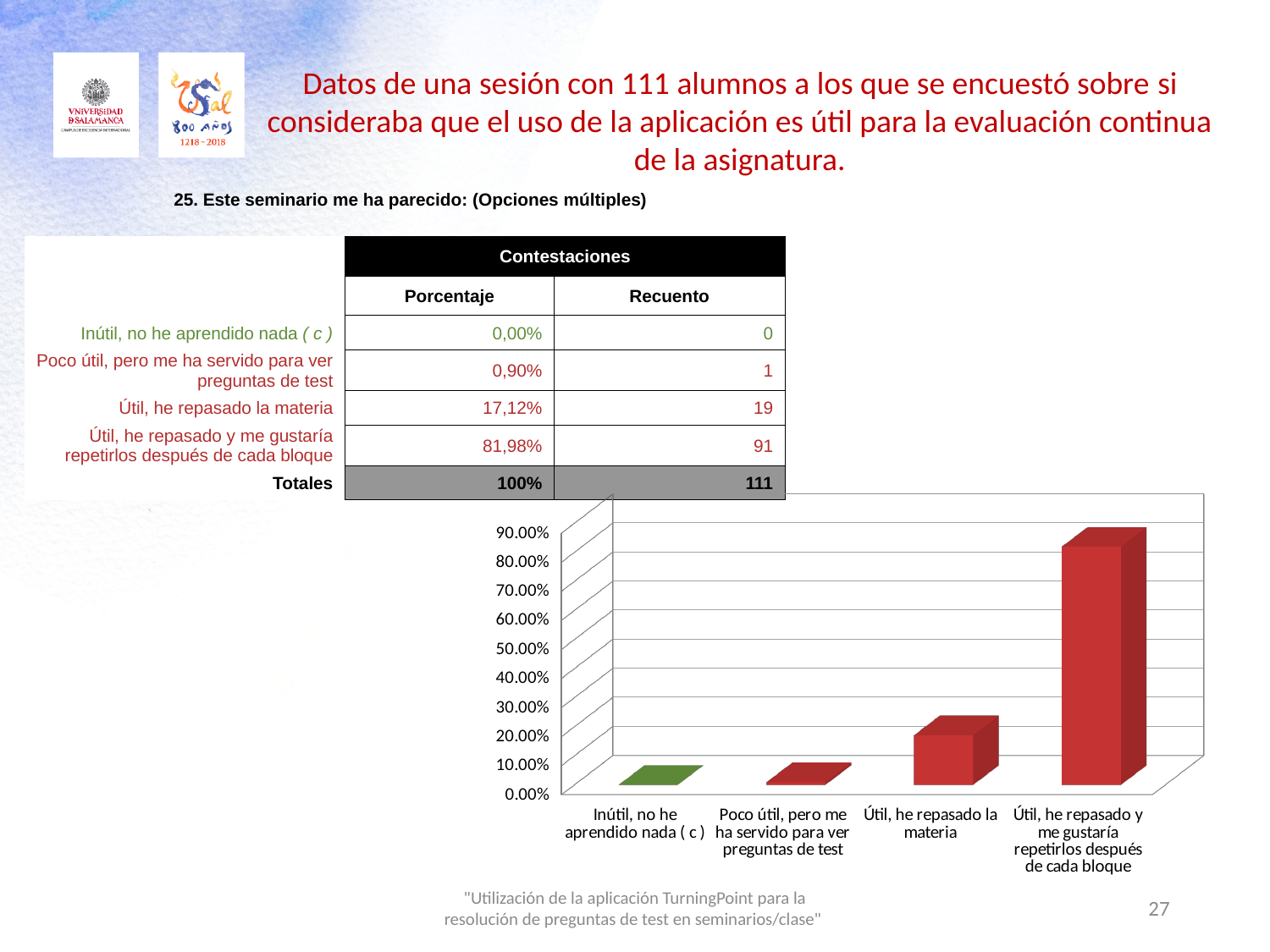
Using the Recuento values in the table, what is the difference between 'Útil, he repasado y me gustaría repetirlos después de cada bloque' and 'Útil, he repasado la materia'? 72 Which category has the lowest value in the chart? Inútil, no he aprendido nada ( c ) What kind of chart is shown on the slide? bar chart Which has a larger value in the chart: 'Poco útil, pero me ha servido para ver preguntas de test' or 'Útil, he repasado la materia'? Útil, he repasado la materia What is the highest tick label shown on the chart's vertical axis? 90.00% Is the value for 'Útil, he repasado la materia' greater or less than 30.00%? less According to the table, what is the Recuento for 'Útil, he repasado y me gustaría repetirlos después de cada bloque'? 91 Is the value for 'Útil, he repasado y me gustaría repetirlos después de cada bloque' greater or less than 70.00%? greater What is the total Recuento shown in the Totales row of the table? 111 How many categories are plotted along the x axis of the chart? 4 According to the table, what is the Porcentaje for 'Útil, he repasado la materia'? 17,12% Which category has the tallest bar in the chart? Útil, he repasado y me gustaría repetirlos después de cada bloque